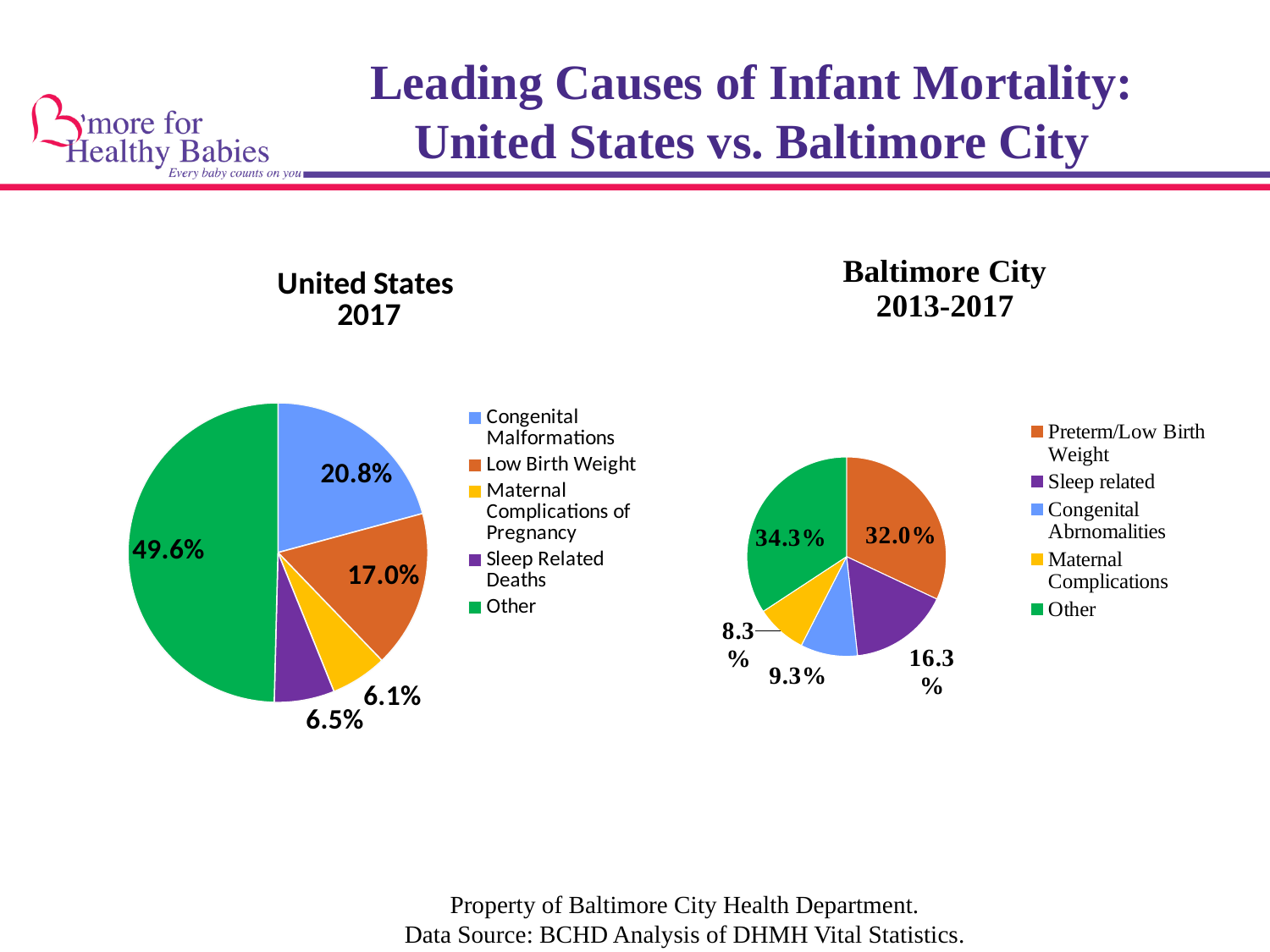
In the United States 2017 pie chart, which category has the largest share? Other In the Baltimore City 2013-2017 pie chart, what share is Maternal Complications? 8.3% In the Baltimore City 2013-2017 pie chart, what share is Sleep related? 16.3% In the Baltimore City 2013-2017 pie chart, which is larger: Sleep related or Congenital Abrnomalities? Sleep related In the Baltimore City 2013-2017 pie chart, which category has the smallest share? Maternal Complications How many categories does the legend of the Baltimore City 2013-2017 pie chart list? 5 In the Baltimore City 2013-2017 pie chart, what share is Preterm/Low Birth Weight? 32.0% In the United States 2017 pie chart, what is the difference between the Congenital Malformations share and the Low Birth Weight share? 3.8% In the United States 2017 pie chart, what share is Congenital Malformations? 20.8% In the United States 2017 pie chart, what share is Sleep Related Deaths? 6.5% In the United States 2017 pie chart, what share is Low Birth Weight? 17.0% What type of chart is used for the United States 2017 data? Pie chart